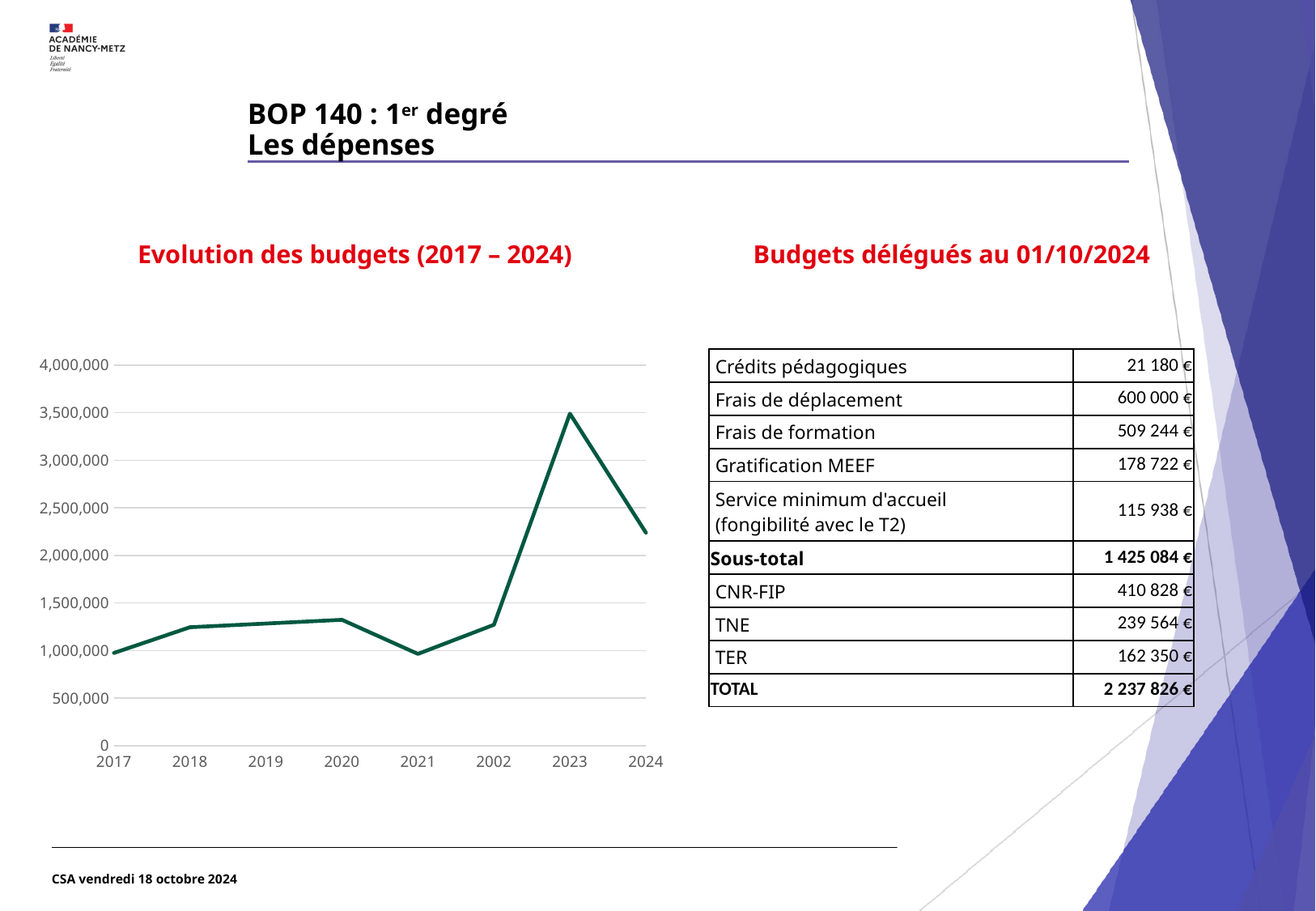
In the "Evolution des budgets (2017 – 2024)" chart, does the line rise or fall between 2023 and 2024? fall In the "Evolution des budgets (2017 – 2024)" chart, which is larger, the value for 2023 or the value for 2024? 2023 In the "Evolution des budgets (2017 – 2024)" chart, is the value for 2020 greater or less than 1,500,000? less In the "Evolution des budgets (2017 – 2024)" chart, which year has the highest value? 2023 In the "Evolution des budgets (2017 – 2024)" chart, is the value for 2024 greater or less than 2,000,000? greater What is the title of the line chart on the left of the slide? Evolution des budgets (2017 – 2024) In the "Evolution des budgets (2017 – 2024)" chart, is the value for 2018 greater or less than 1,000,000? greater In the "Evolution des budgets (2017 – 2024)" chart, which is larger, the value for 2020 or the value for 2021? 2020 In the "Evolution des budgets (2017 – 2024)" chart, how many points are plotted along the x axis? 8 What kind of chart is shown under the title "Evolution des budgets (2017 – 2024)"? line chart